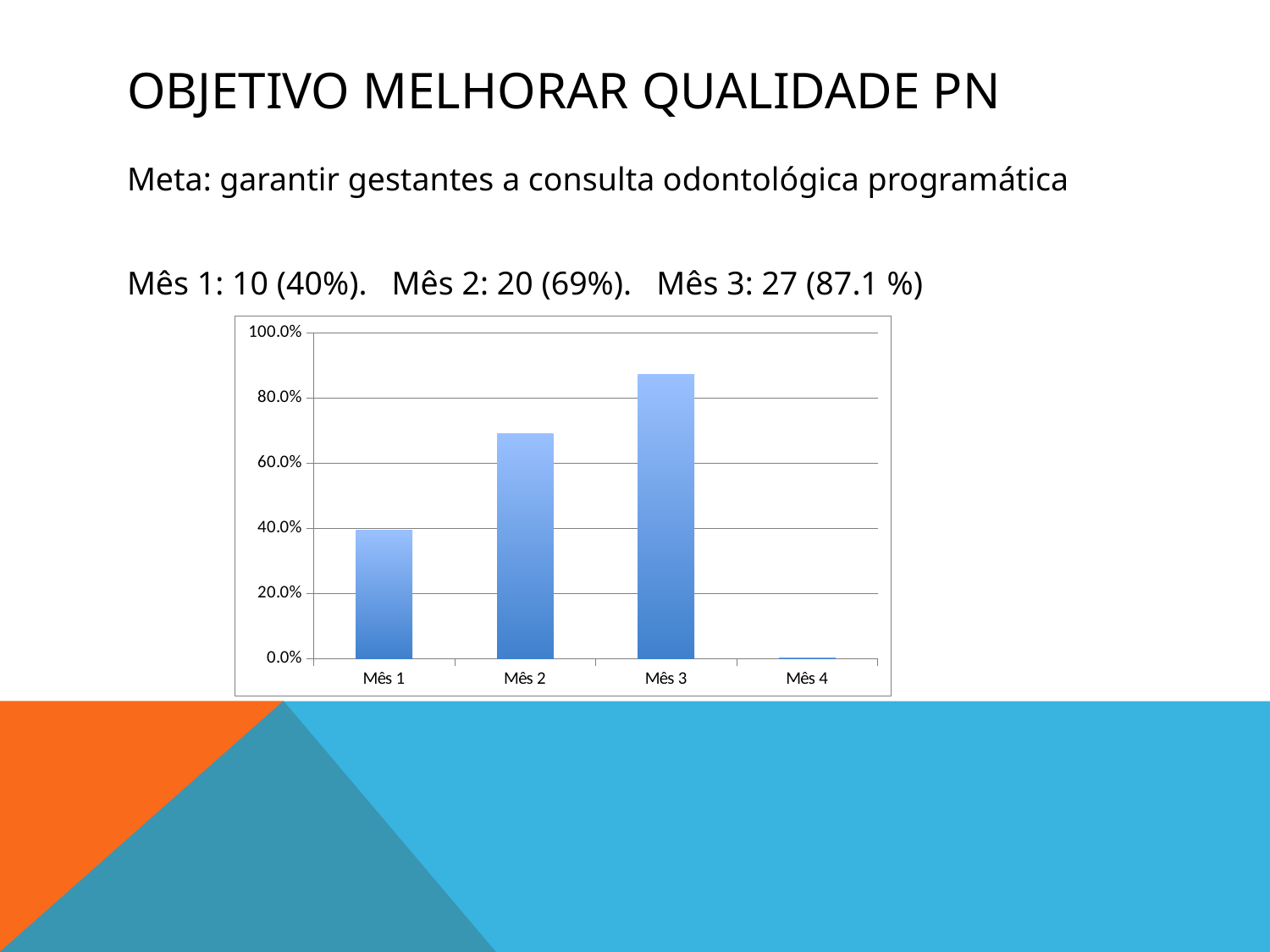
What is the highest tick value shown on the y axis of the chart? 100.0% Which category has the lowest bar in the chart? Mês 4 Is the value for Mês 1 greater or less than 20.0%? greater Which is larger, the value for Mês 1 or the value for Mês 2? Mês 2 Is the value for Mês 2 greater or less than 60.0%? greater Is the value for Mês 2 greater or less than 80.0%? less According to the text above the chart, what percentage is given for Mês 2? 69% Do the values rise or fall from Mês 1 to Mês 3? rise Which category has the highest bar in the chart? Mês 3 What kind of chart is shown on the slide? bar chart How many categories are shown on the x axis of the chart? 4